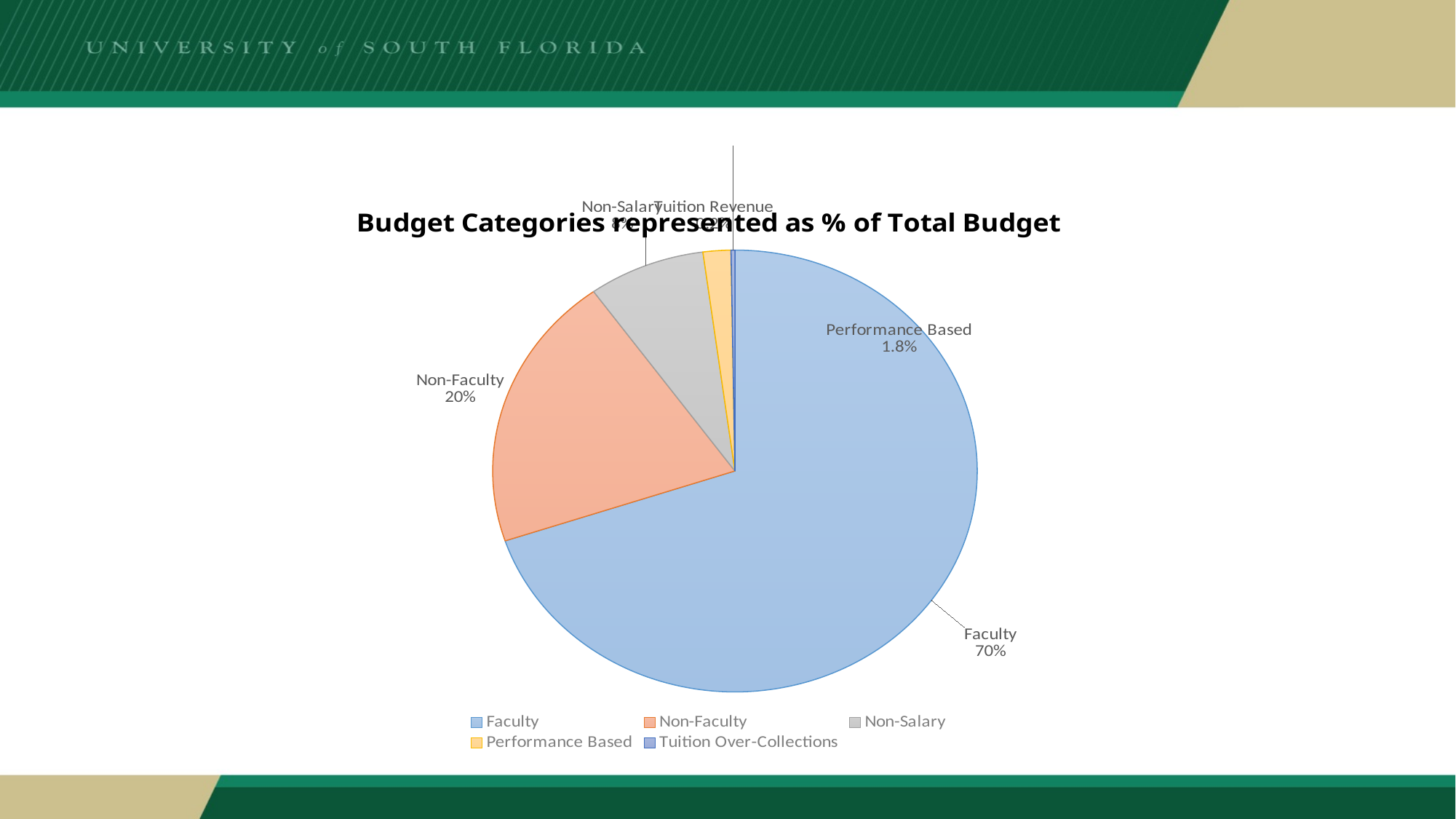
Which is larger, the Faculty share or the Non-Faculty share? Faculty How many percentage points larger is the Faculty share than the Non-Faculty share? 50 percentage points What percentage of the total budget is Faculty? 70% What kind of chart is shown on the slide? Pie chart What is the title of the chart? Budget Categories represented as % of Total Budget What colour is the Faculty slice of the pie? Blue What percentage of the total budget is Performance Based? 1.8% Which is larger, the Non-Faculty share or the Non-Salary share? Non-Faculty Which budget category has the smallest share of the pie? Tuition Over-Collections Which budget category has the largest share of the pie? Faculty What percentage of the total budget is Non-Faculty? 20% How many budget categories does the legend list? 5